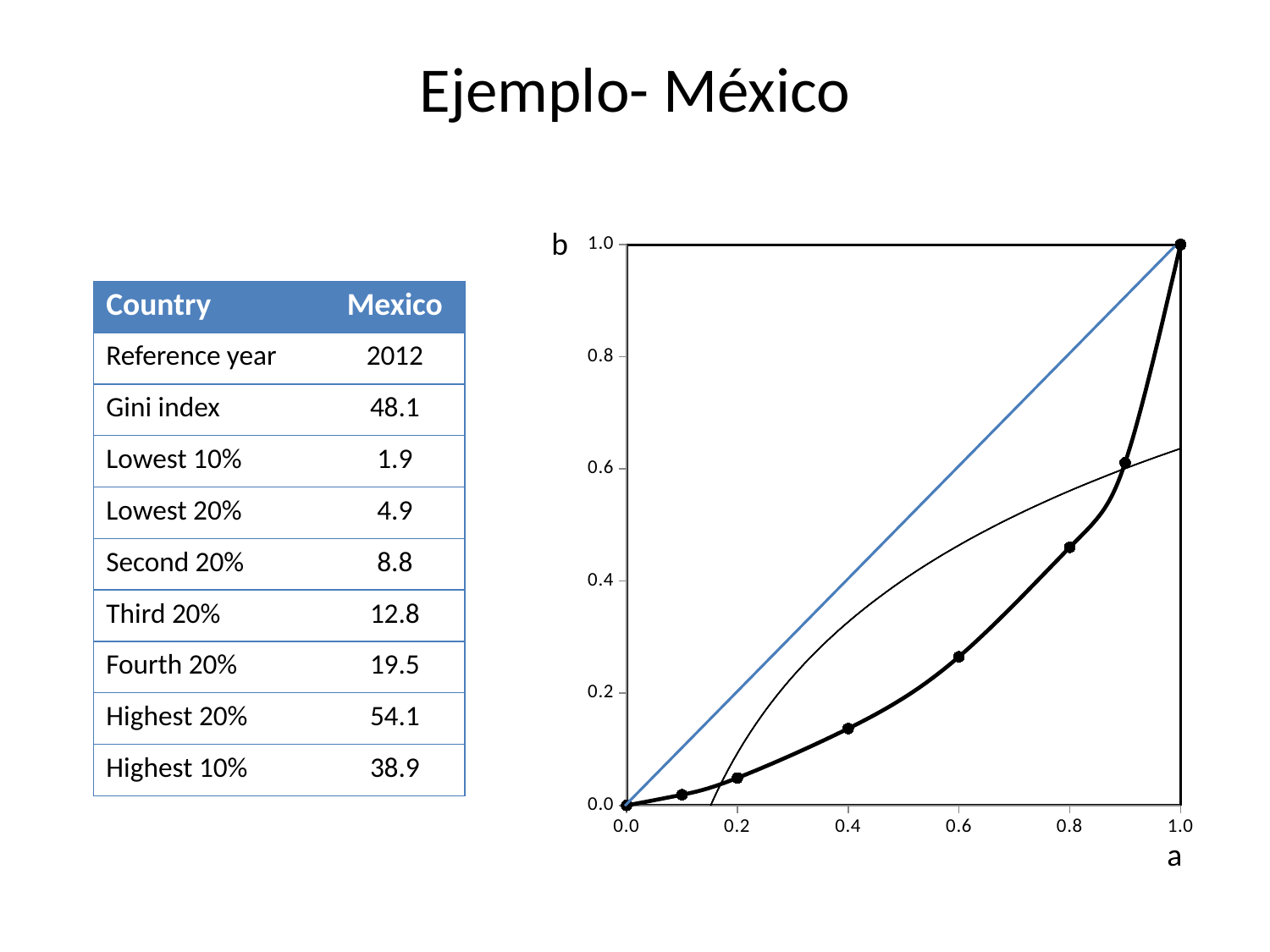
Is the value of b on the thick curve at a = 0.8 greater or less than 0.4? greater What is the value of b on the thick curve when a is 0.0? 0.0 What kind of chart is shown on the slide? line chart Does the thick curve rise or fall as a increases from 0.0 to 1.0? rises Is the value of b on the thick curve at a = 0.6 greater or less than 0.2? greater What is the label of the vertical axis of the chart? b What is the label of the horizontal axis of the chart? a On the thick curve, which has the larger b value: a = 0.6 or a = 0.8? a = 0.8 Is the value of b on the thick curve at a = 0.9 greater or less than 0.8? less What is the value of b on the thick curve when a is 1.0? 1.0